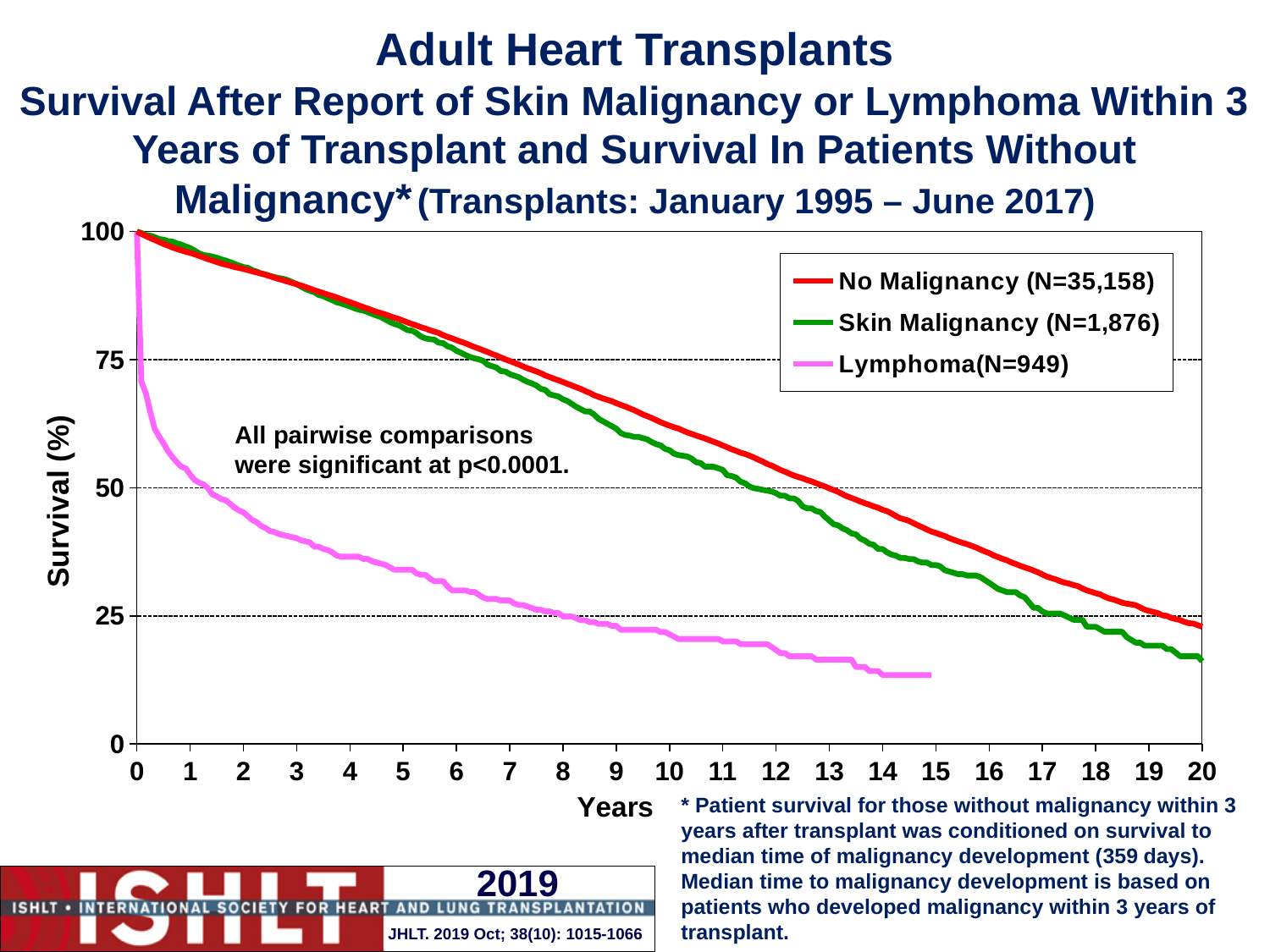
Is the survival value for No Malignancy at 10 years greater or less than 50? greater At 10 years, which series has higher survival: No Malignancy or Lymphoma? No Malignancy Do the survival curves rise or fall as years since transplant increase? Fall What is the N shown in the legend for the Lymphoma series? 949 What kind of chart is shown on the slide? Line chart Is the survival value for Lymphoma at 5 years greater or less than 50? less Is the survival value for Skin Malignancy at 5 years greater or less than 75? greater Which series has the lowest survival at 10 years? Lymphoma How many series does the legend list? 3 Which series has the highest survival at 15 years? No Malignancy